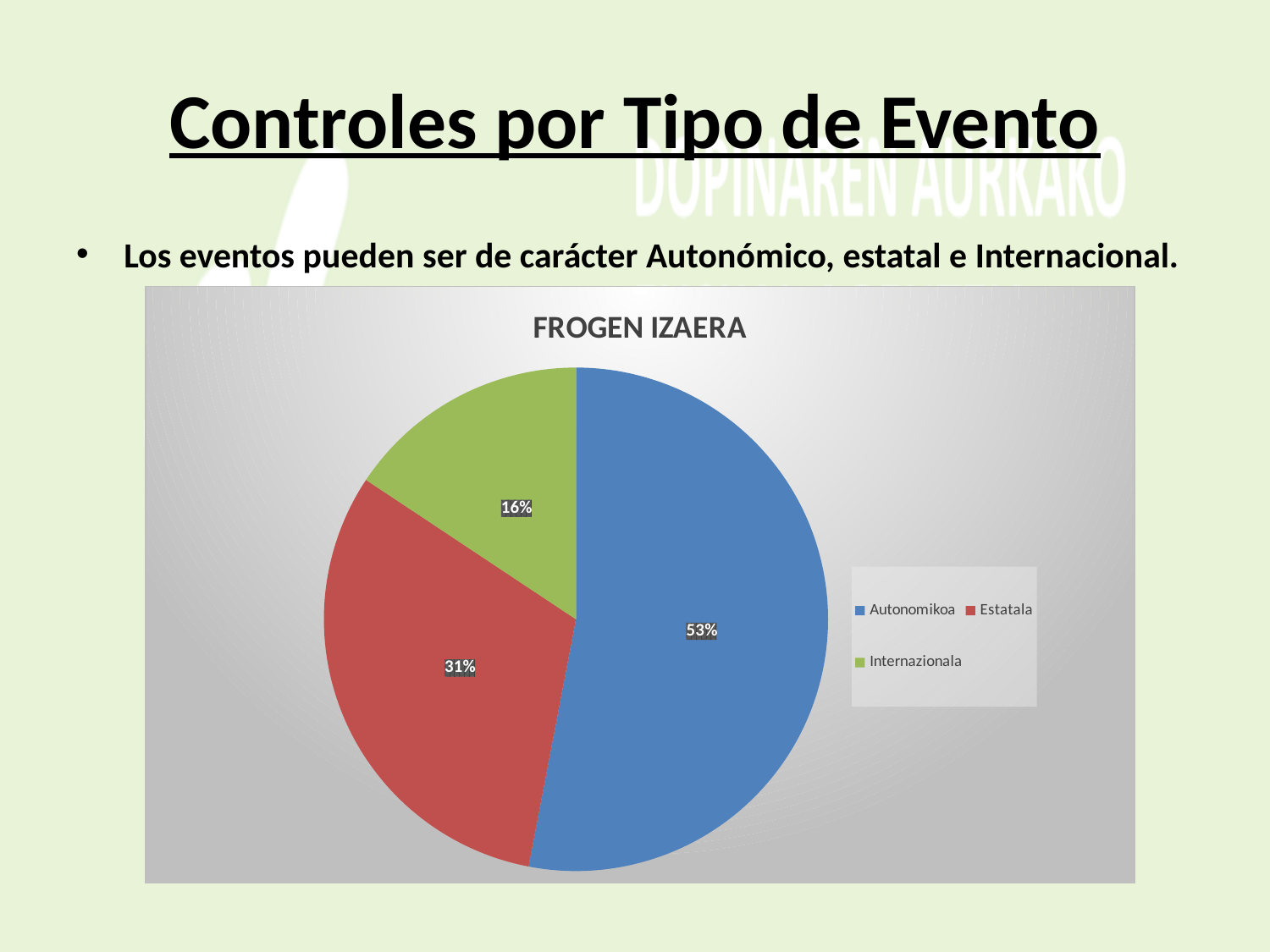
How many categories does the pie chart show? 3 What share of the pie does Estatala represent? 31% What kind of chart is shown on the slide? pie chart What share of the pie does Autonomikoa represent? 53% What is the difference in percentage points between Autonomikoa and Estatala? 22 What is the difference in percentage points between Estatala and Internazionala? 15 What colour is the Estatala slice? red Which category has the largest slice of the pie? Autonomikoa Which category has the smallest slice of the pie? Internazionala Which is larger, the Estatala slice or the Internazionala slice? Estatala What is the title of the chart? FROGEN IZAERA What share of the pie does Internazionala represent? 16%